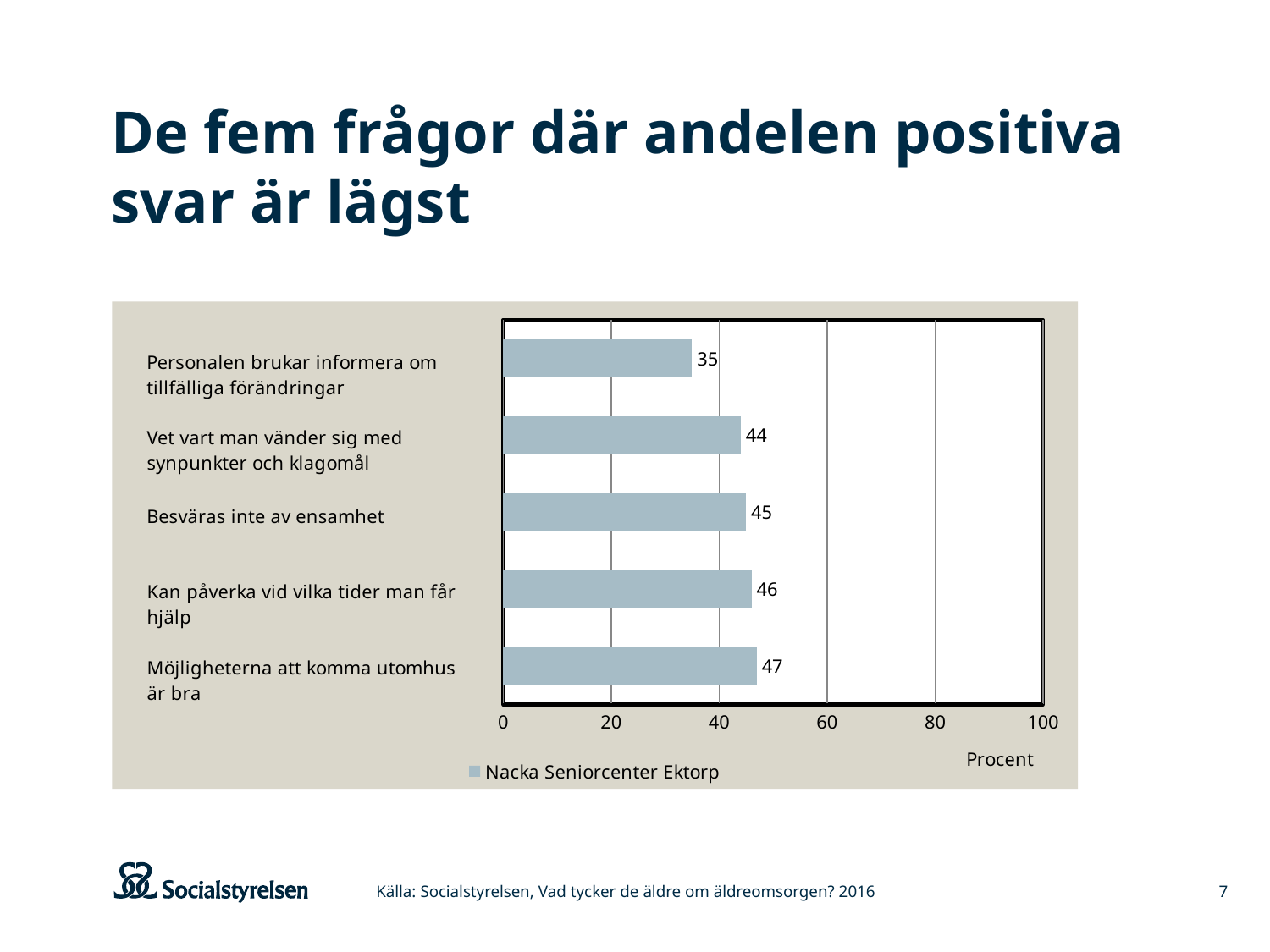
How many categories are shown in the chart? 5 Is the value for "Personalen brukar informera om tillfälliga förändringar" greater or less than 40? less What is the difference between the values for "Möjligheterna att komma utomhus är bra" and "Personalen brukar informera om tillfälliga förändringar"? 12 How many series does the legend list? 1 What is the value for "Möjligheterna att komma utomhus är bra"? 47 What kind of chart is shown on the slide? bar chart Which is larger: the value for "Vet vart man vänder sig med synpunkter och klagomål" or the value for "Kan påverka vid vilka tider man får hjälp"? Kan påverka vid vilka tider man får hjälp Which category has the highest value? Möjligheterna att komma utomhus är bra What is the value for "Personalen brukar informera om tillfälliga förändringar"? 35 What is the name of the series shown in the legend? Nacka Seniorcenter Ektorp Which category has the lowest value? Personalen brukar informera om tillfälliga förändringar What is the value for "Besväras inte av ensamhet"? 45